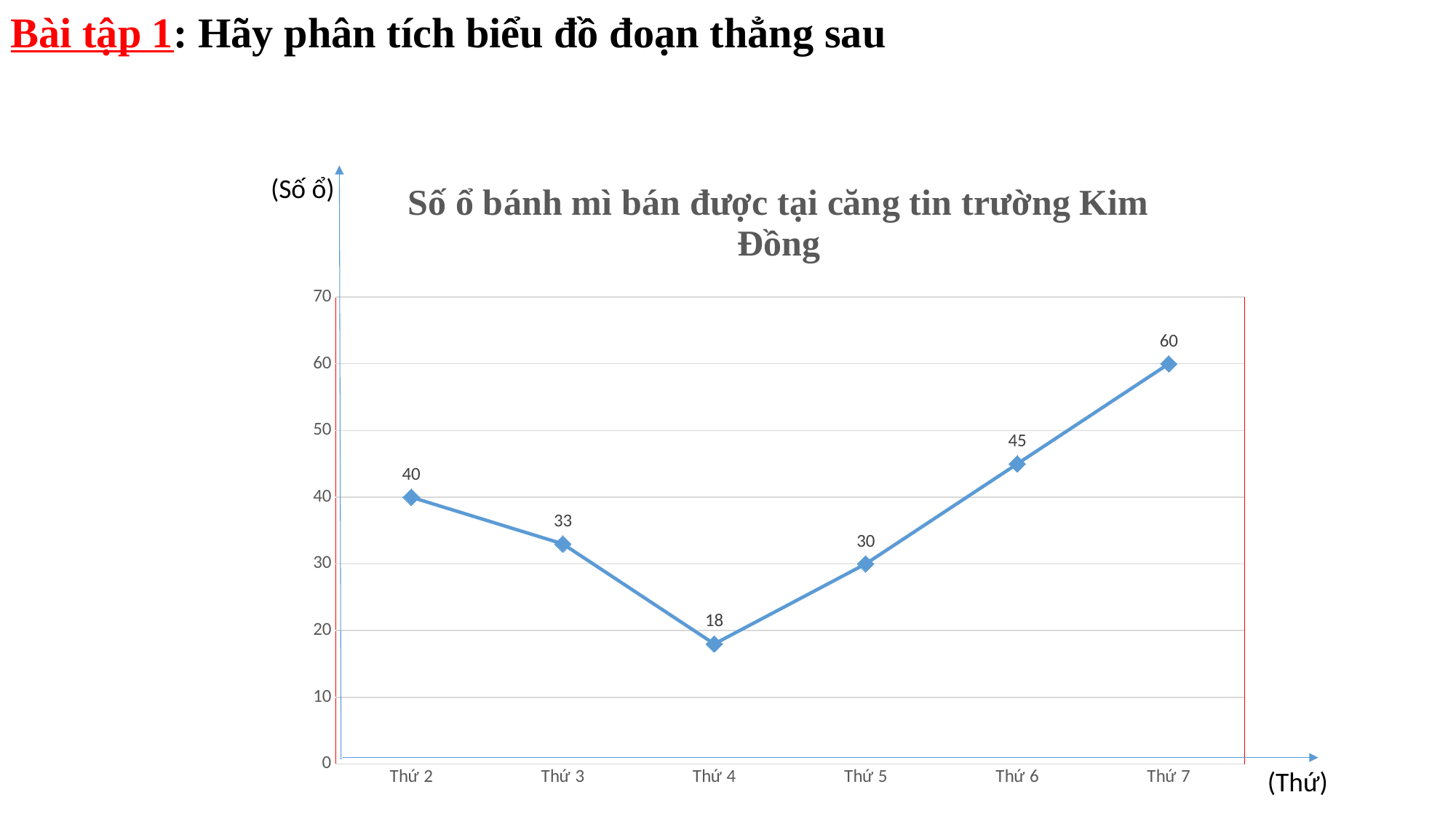
What is the difference between the values for Thứ 7 and Thứ 2? 20 What is the value for Thứ 7? 60 What kind of chart is shown? line chart Do the values rise or fall from Thứ 4 to Thứ 7? rise How many days are plotted on the chart? 6 Which day has the lowest value? Thứ 4 What is the difference between the values for Thứ 6 and Thứ 5? 15 Which day has the highest value? Thứ 7 What is the title of the chart? Số ổ bánh mì bán được tại căng tin trường Kim Đồng Which is larger, the value for Thứ 2 or the value for Thứ 5? Thứ 2 What is the value for Thứ 3? 33 What is the value for Thứ 4? 18